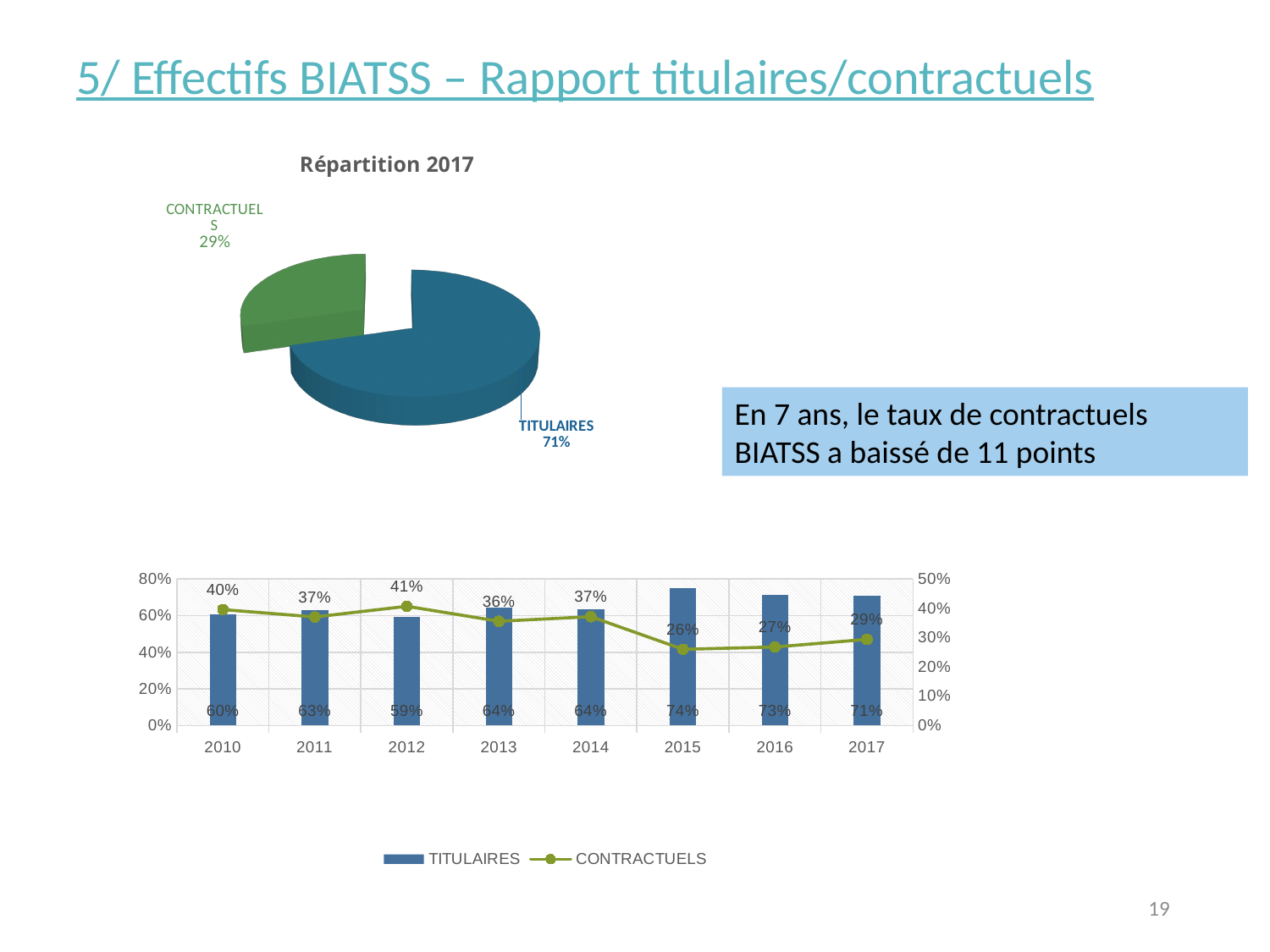
How many years are shown on the x axis of the bottom chart? 8 What type of chart is the chart titled 'Répartition 2017'? Pie chart In the pie chart 'Répartition 2017', what share is labelled for TITULAIRES? 71% In the bottom chart, which is larger: the TITULAIRES value for 2013 or for 2012? 2013 In the bottom chart, which year has the lowest CONTRACTUELS value? 2015 In the bottom chart, what is the CONTRACTUELS value for 2012? 41% In the bottom chart, what is the TITULAIRES value for 2010? 60% How many series does the legend of the bottom chart list? 2 In the pie chart 'Répartition 2017', what share is labelled for CONTRACTUELS? 29% In the bottom chart, what is the difference between the CONTRACTUELS value in 2010 and in 2017? 11 percentage points In the bottom chart, what is the TITULAIRES value for 2015? 74% In the bottom chart, which year has the highest TITULAIRES value? 2015